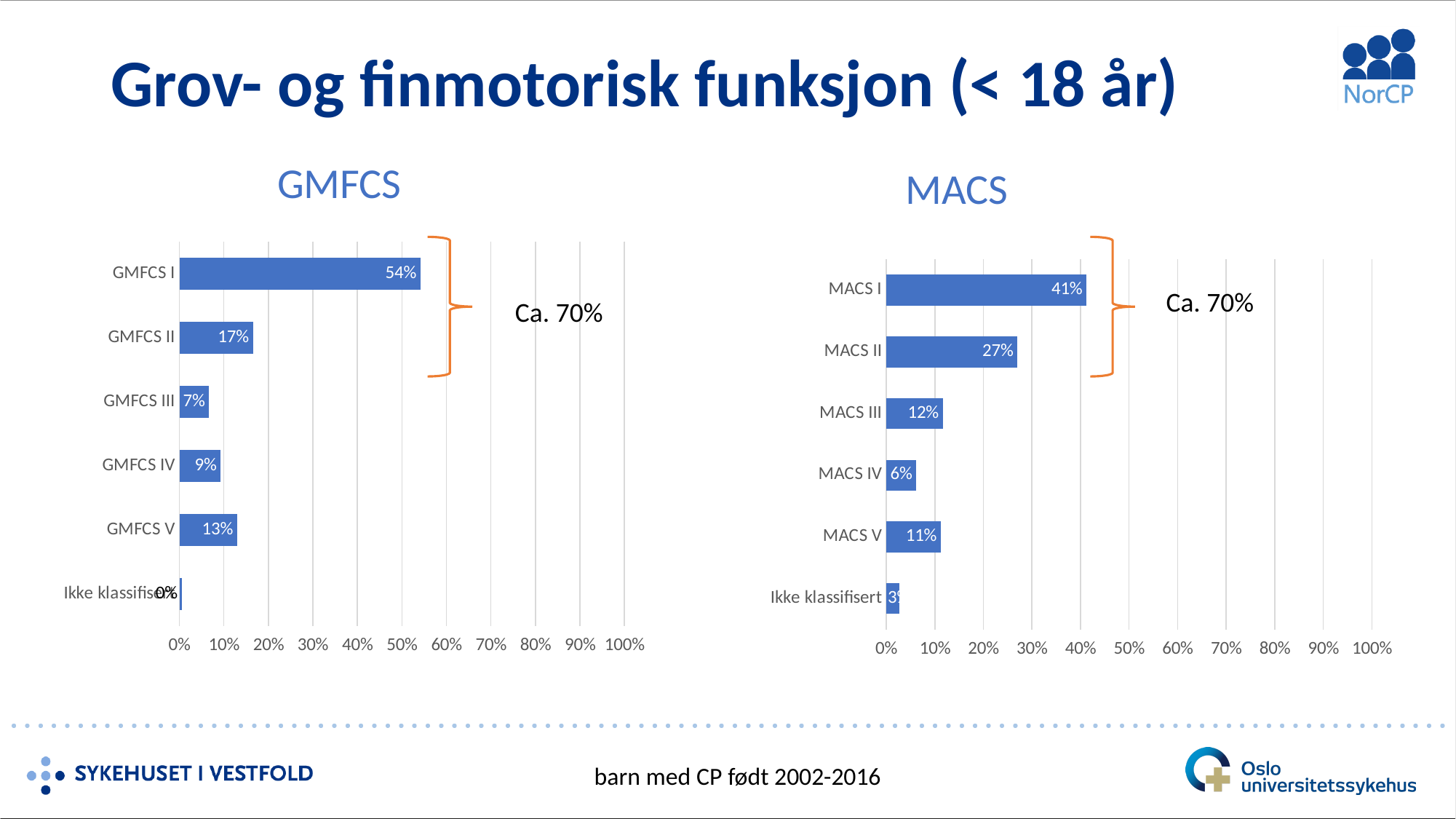
In the MACS chart, which category has the lowest value? Ikke klassifisert What kind of chart is the GMFCS chart? bar chart What is the title of the chart on the right side of the slide? MACS In the MACS chart, what is the difference between MACS I and MACS III? 29% In the GMFCS chart, which category has the highest value? GMFCS I In the MACS chart, what is the value for MACS II? 27% In the GMFCS chart, what is the total of GMFCS I and GMFCS II? 71% In the GMFCS chart, what is the difference between GMFCS I and GMFCS II? 37% In the GMFCS chart, what is the value for GMFCS I? 54% How many categories are shown in the MACS chart? 6 In the MACS chart, is the value for MACS I greater or less than 50%? less In the GMFCS chart, which is larger, GMFCS IV or GMFCS V? GMFCS V